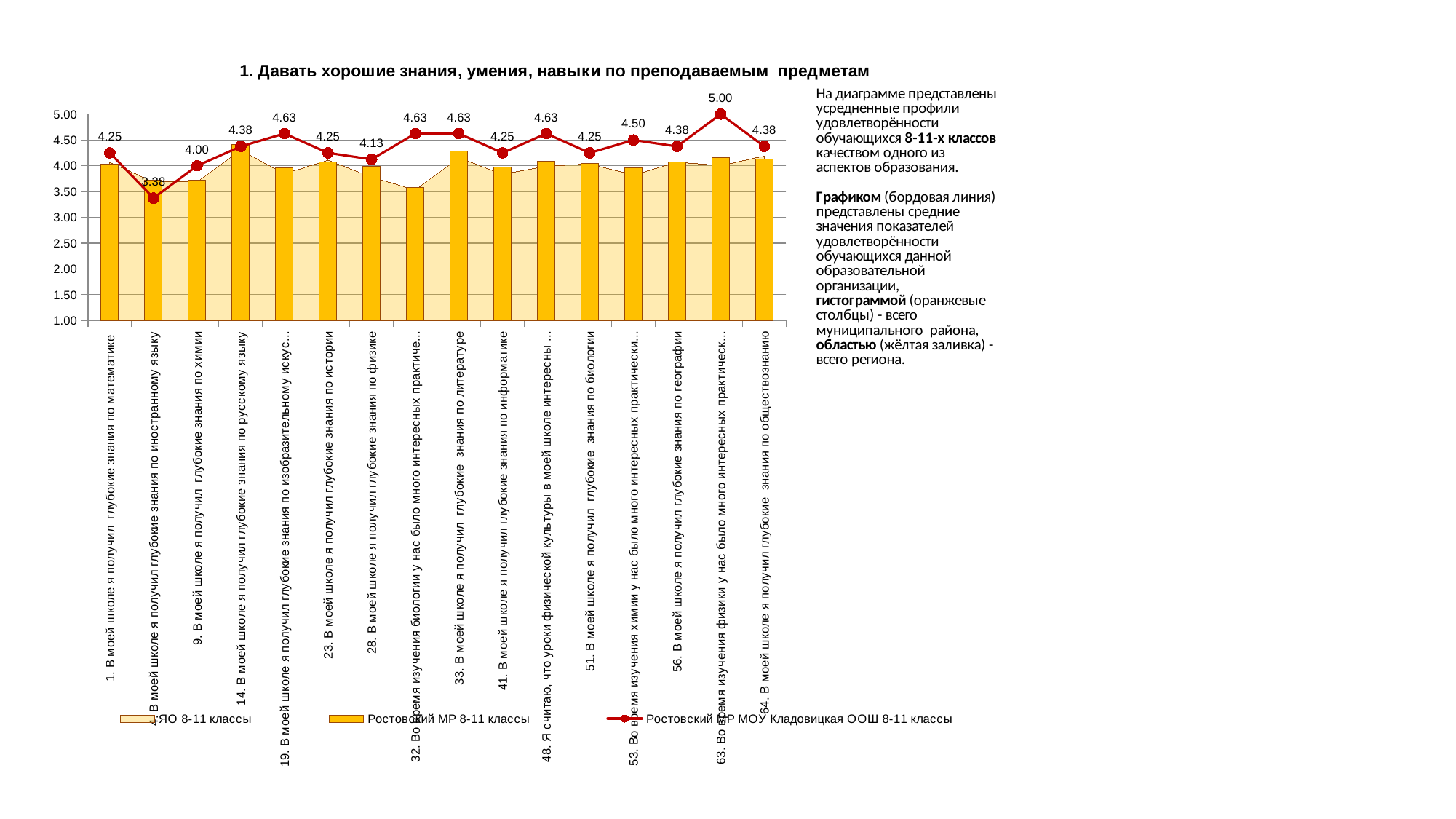
Which category has the highest value on the line series? 63. Во время изучения физики у нас было много интересных практическ... (5.00) What is the value of the line series for "56. В моей школе я получил глубокие знания по географии"? 4.38 What is the value of the line series for "4. В моей школе я получил глубокие знания по иностранному языку"? 3.38 What is the value of the line series (Ростовский МР МОУ Кладовицкая ООШ 8-11 классы) for "1. В моей школе я получил глубокие знания по математике"? 4.25 On the line series, which is larger: the value for "14. ... по русскому языку" or for "9. ... по химии"? 14. ... по русскому языку (4.38) Is the orange bar (Ростовский МР 8-11 классы) for "14. В моей школе я получил глубокие знания по русскому языку" greater or less than 4.00? greater How many categories are shown on the x axis of the chart? 16 What kind of chart is shown on the slide? A combination chart: an area series (yellow fill), a bar series (orange bars) and a line series How many series does the legend list? 3 Which category has the lowest value on the line series? 4. В моей школе я получил глубокие знания по иностранному языку (3.38) Is the orange bar (Ростовский МР 8-11 классы) for "32. Во время изучения биологии у нас было много интересных практиче..." greater or less than 4.00? less What is the difference between the highest (5.00) and lowest (3.38) values on the line series? 1.62